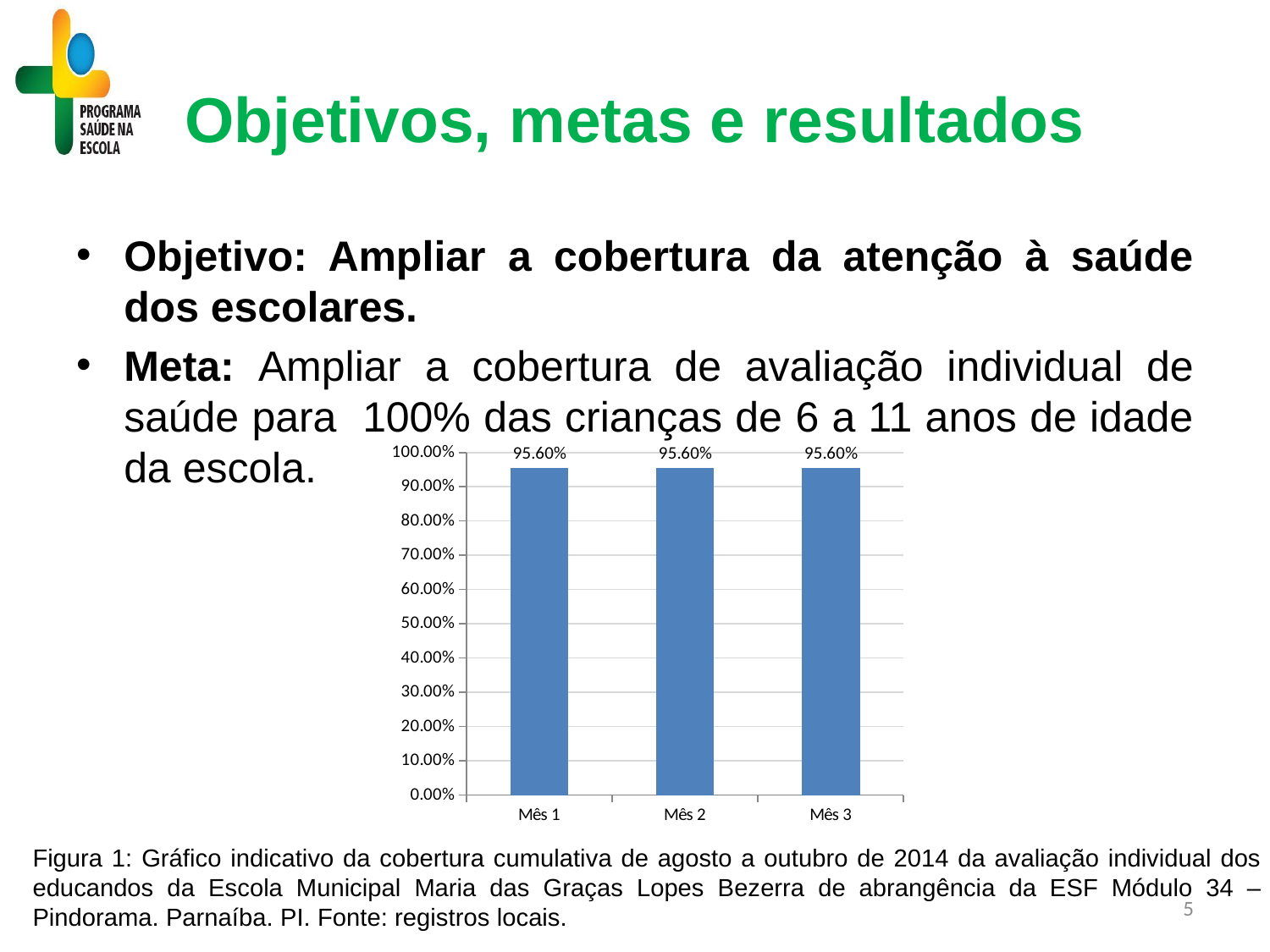
What is the difference between the values for Mês 1 and Mês 3? 0.00% What is the value for Mês 1? 95.60% Is the value for Mês 3 greater or less than 100.00%? less What is the value for Mês 3? 95.60% What is the label of the first category on the x axis? Mês 1 How many categories are shown on the x axis of the chart? 3 What is the highest tick shown on the y axis of the chart? 100.00% Is the value for Mês 2 greater or less than 90.00%? greater Do the values rise, fall or stay the same from Mês 1 to Mês 3? stay the same What kind of chart is shown on the slide? bar chart What is the value for Mês 2? 95.60%